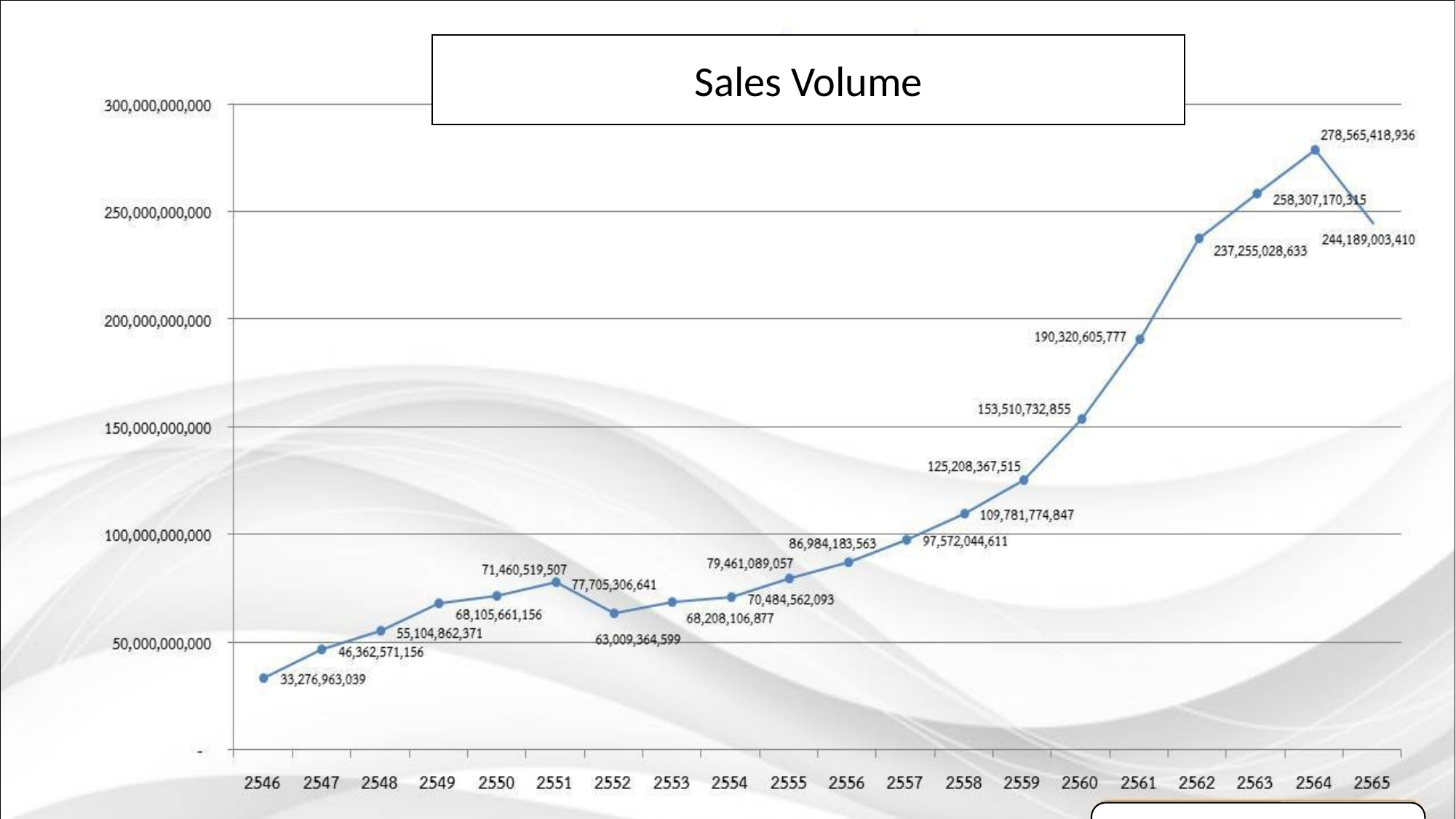
What is the sales volume for 2564? 278,565,418,936 What is the sales volume for 2561? 190,320,605,777 What is the difference between the sales volume in 2564 and in 2565? 34,376,415,526 Which year has the larger sales volume, 2551 or 2552? 2551 Which year has the highest sales volume? 2564 What is the sales volume for 2546? 33,276,963,039 What type of chart is shown on the slide? Line chart What is the sales volume for 2552? 63,009,364,599 How many years are plotted on the x axis? 20 Is the sales volume for 2560 greater or less than 150,000,000,000? greater Which year has the lowest sales volume? 2546 What is the title of the chart? Sales Volume